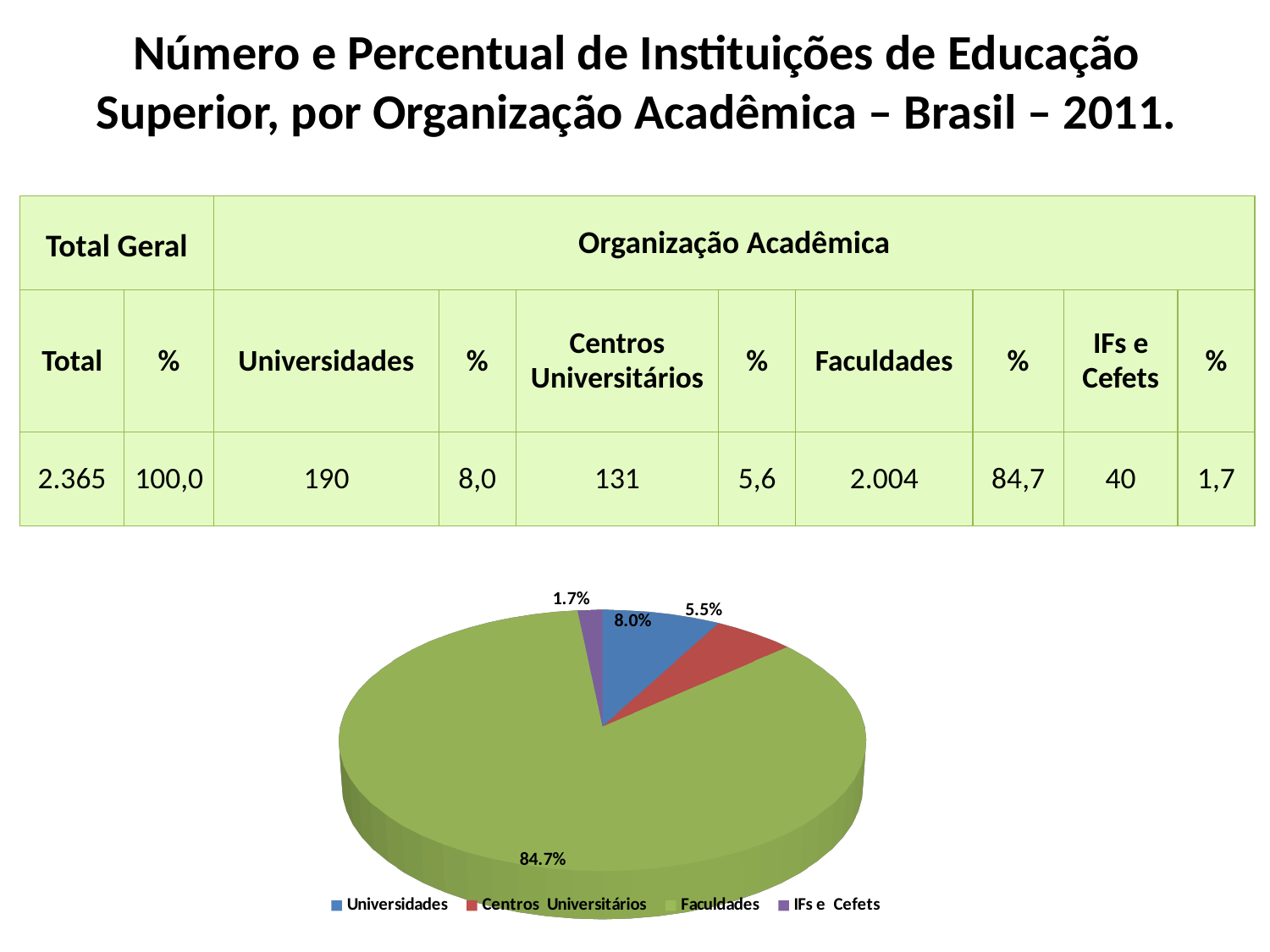
How many entries does the pie chart's legend list? 4 What kind of chart is shown on the slide? pie chart In the pie chart, what share is labelled for Centros Universitários? 5.5% How many slices does the pie chart have? 4 Which slice is larger in the pie chart, Universidades or Centros Universitários? Universidades In the pie chart, what share is labelled for Faculdades? 84.7% In the pie chart, what share is labelled for IFs e Cefets? 1.7% Which category has the smallest slice in the pie chart? IFs e Cefets What colour is the Faculdades slice in the pie chart? green In the pie chart, what share is labelled for Universidades? 8.0% Which category has the largest slice in the pie chart? Faculdades What is the difference in percentage points between the Universidades slice and the IFs e Cefets slice in the pie chart? 6.3